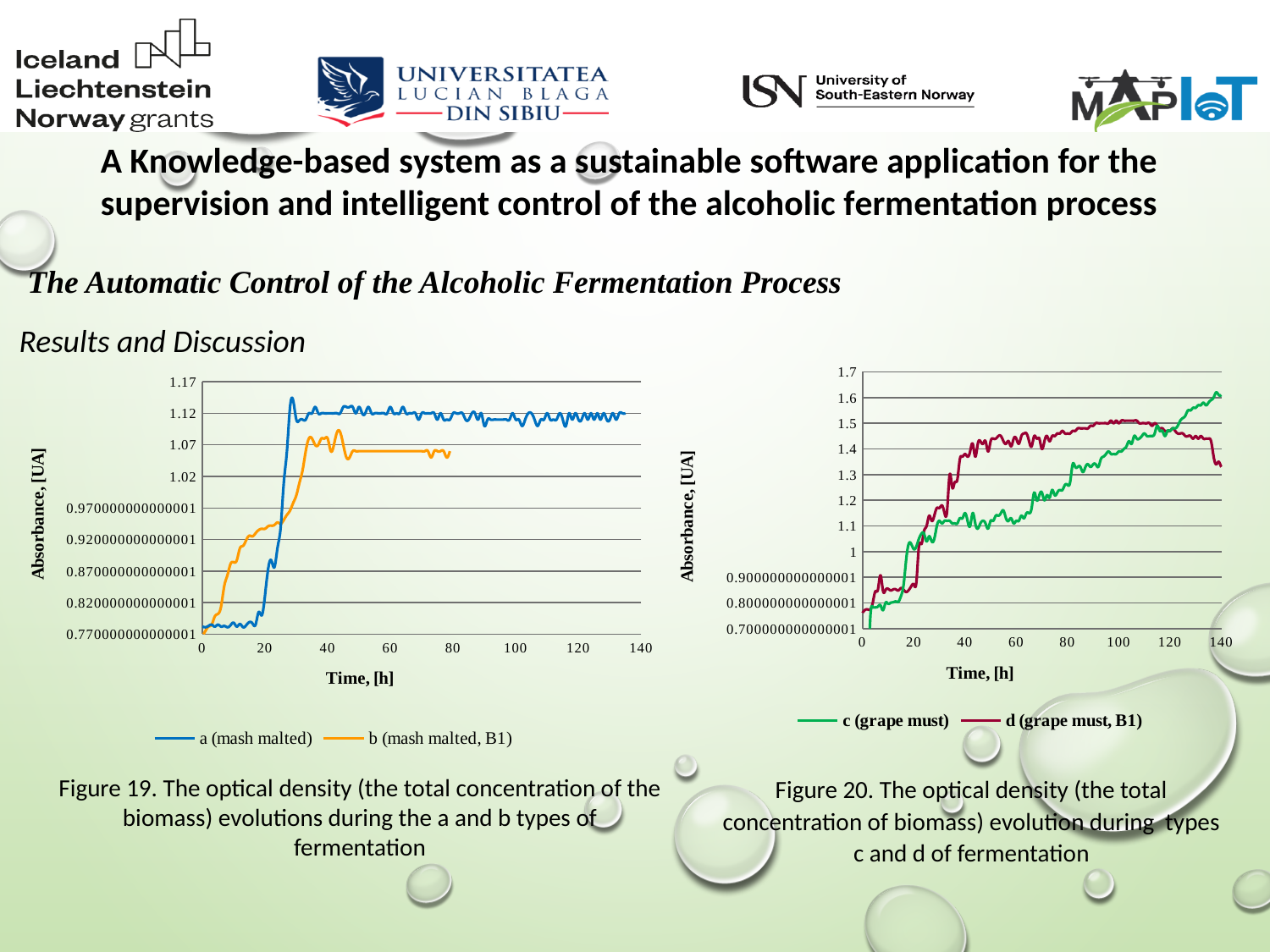
In Figure 20, does series c (grape must) generally rise or fall as time increases? rise In Figure 19, is the value of series a (mash malted) at time 100 h greater or less than 1.07? greater What is the x-axis title of the chart in Figure 19? Time, [h] What kind of chart is shown in Figure 19? line chart In Figure 20, is the value of series d (grape must, B1) at time 60 h greater or less than 1.3? greater In Figure 19, is the value of series b (mash malted, B1) at time 60 h greater or less than 1.02? greater In Figure 20, which series has the higher value at time 140 h, c (grape must) or d (grape must, B1)? c (grape must) How many series does the legend of Figure 20 list? 2 In Figure 20, which series has the higher value at time 60 h, c (grape must) or d (grape must, B1)? d (grape must, B1)